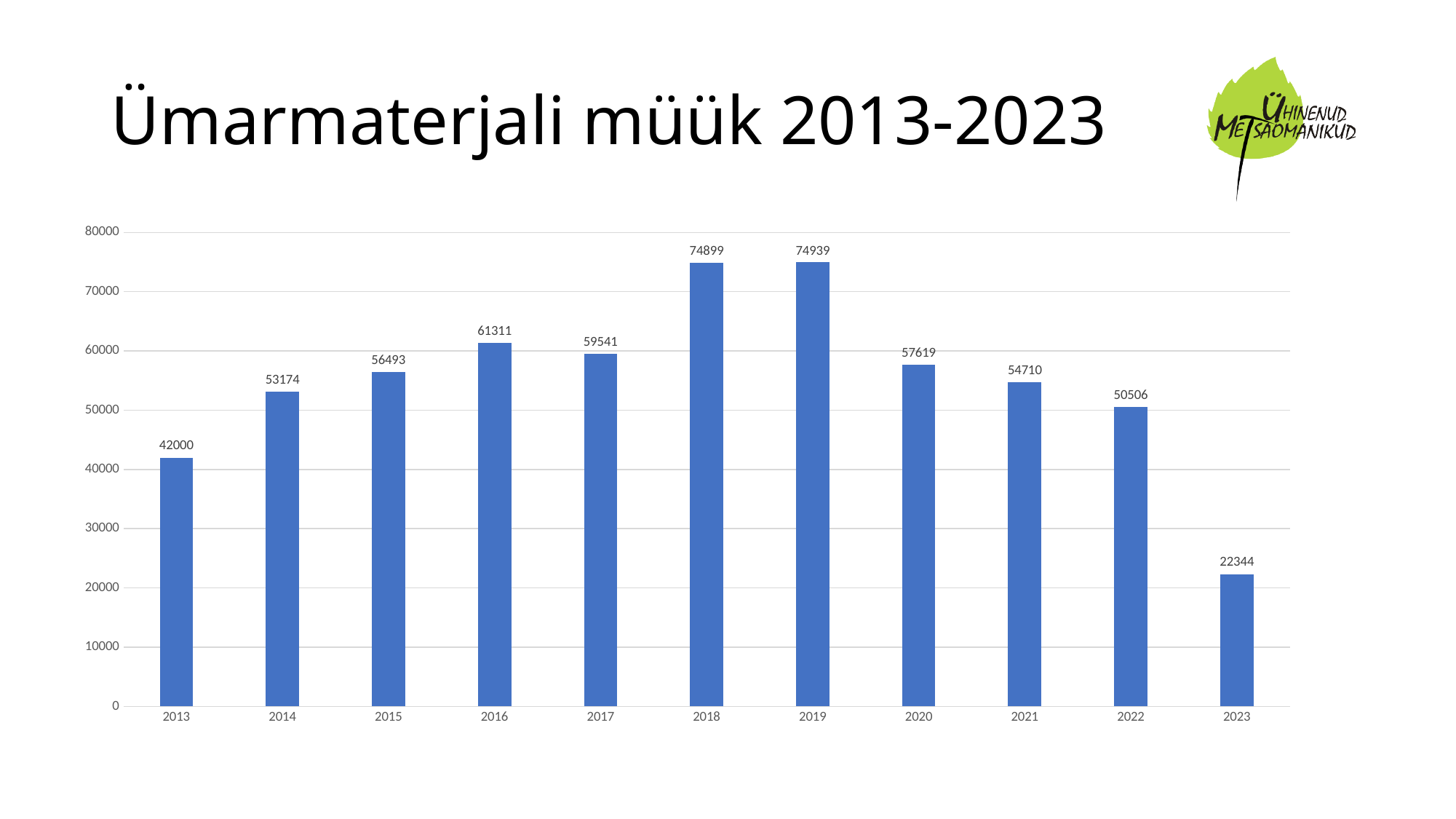
What is the value for 2020? 57619 Which year has the lowest value? 2023 What type of chart is shown on the slide? bar chart Is the value for 2022 greater or less than 60000? less Which year has the highest value? 2019 What is the value for 2023? 22344 What is the difference between the values for 2016 and 2017? 1770 What is the value for 2018? 74899 What is the value for 2013? 42000 What is the title of the slide? Ümarmaterjali müük 2013-2023 Which is larger, the value for 2014 or the value for 2021? 2021 How many years are shown on the x axis? 11